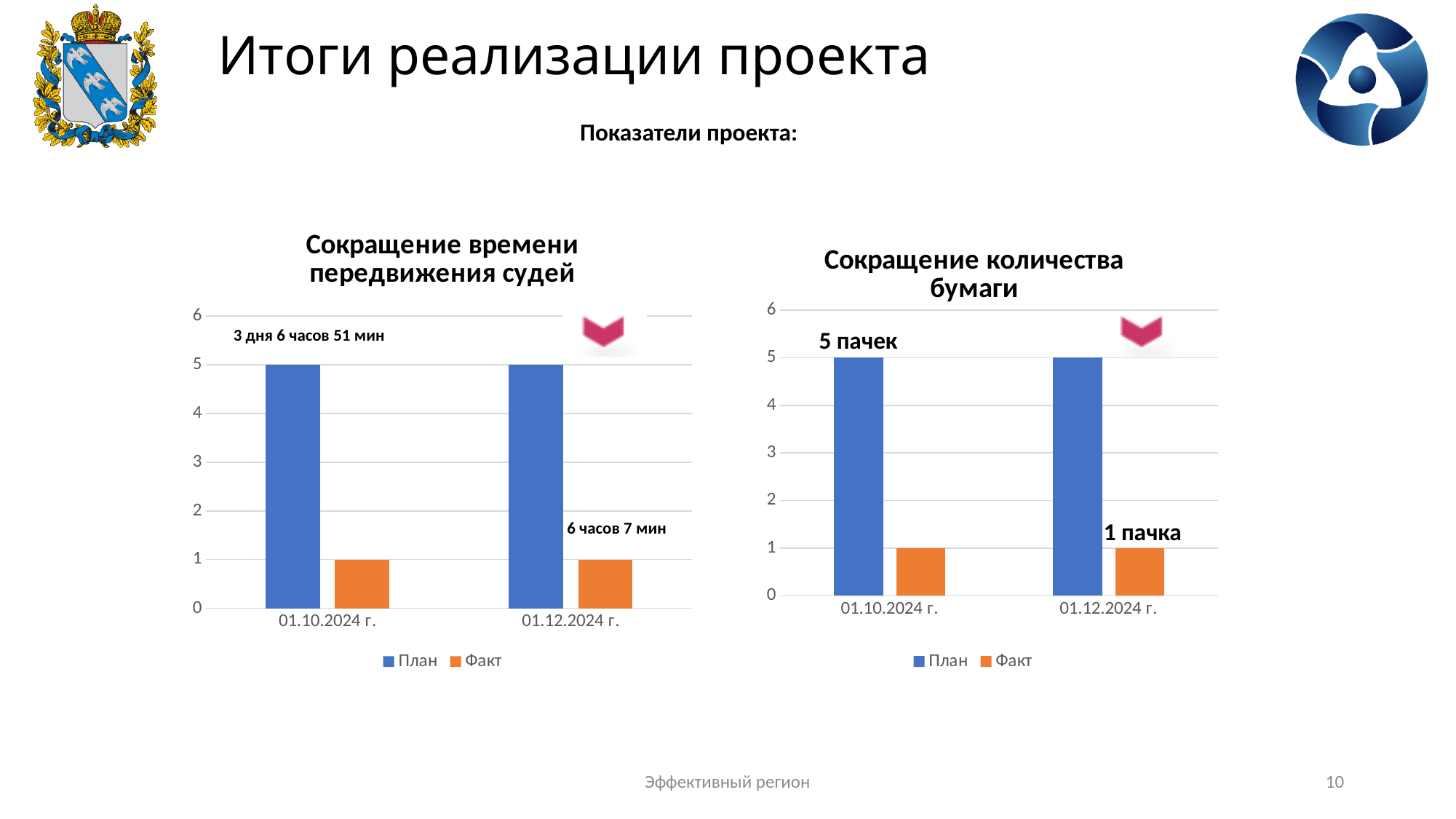
In the right chart "Сокращение количества бумаги", is the value of Факт for 01.10.2024 г. greater or less than 3? less In the left chart "Сокращение времени передвижения судей", which series is larger for 01.10.2024 г., План or Факт? План In the right chart "Сокращение количества бумаги", what is the difference between План and Факт for 01.12.2024 г.? 4 What type of chart is the left chart titled "Сокращение времени передвижения судей"? bar chart In the right chart "Сокращение количества бумаги", what is the value of Факт for 01.12.2024 г.? 1 In the right chart "Сокращение количества бумаги", what text label is shown near the 01.10.2024 г. bars? 5 пачек In the left chart "Сокращение времени передвижения судей", what is the value of План for 01.12.2024 г.? 5 In the left chart "Сокращение времени передвижения судей", how many categories are shown on the x axis? 2 How many series does the legend of the right chart "Сокращение количества бумаги" list? 2 In the right chart "Сокращение количества бумаги", what is the value of План for 01.10.2024 г.? 5 In the left chart "Сокращение времени передвижения судей", what is the total of План and Факт for 01.10.2024 г.? 6 In the left chart "Сокращение времени передвижения судей", what text label is shown near the 01.12.2024 г. bars? 6 часов 7 мин